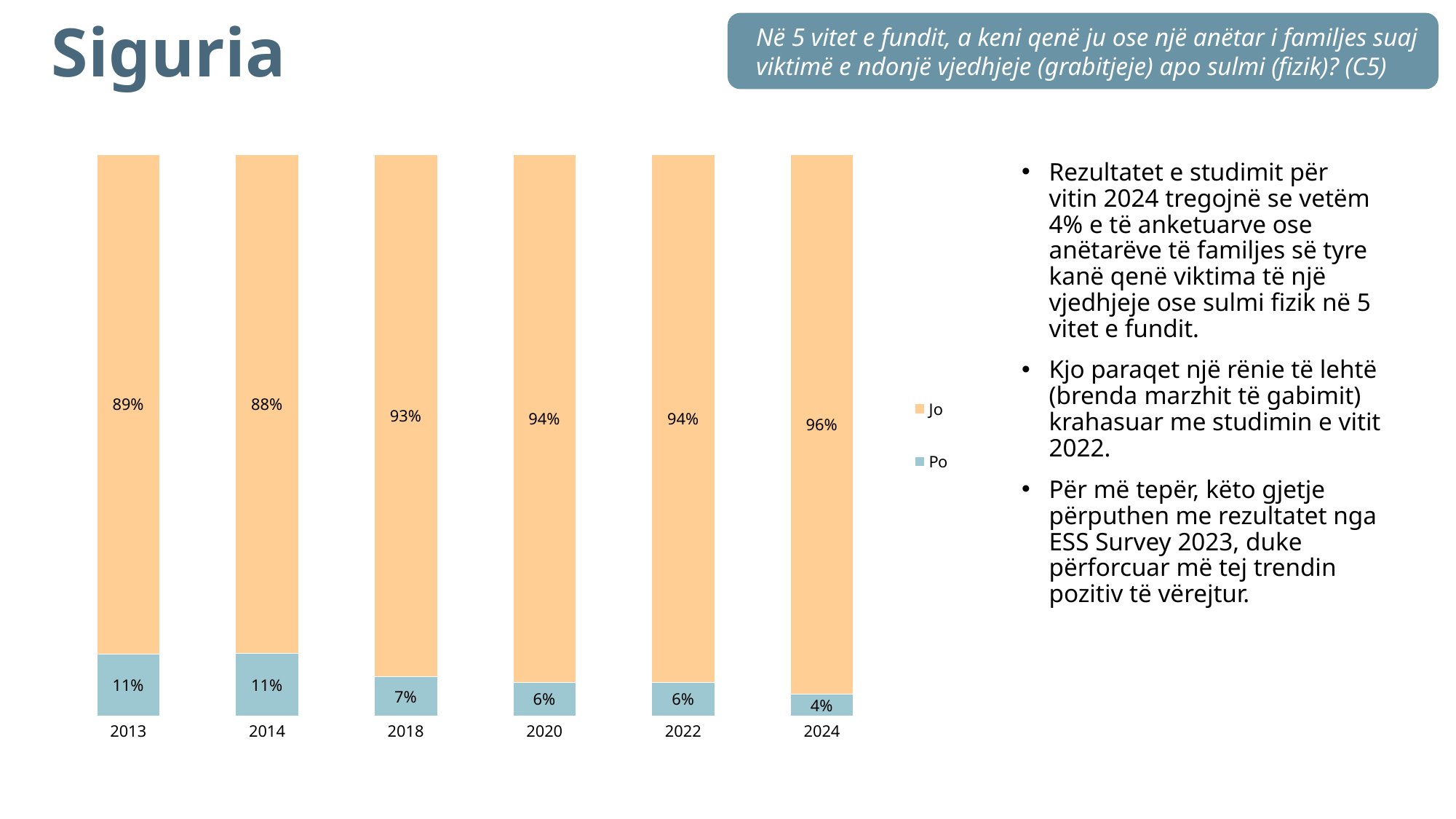
In which year is the "Po" value lowest? 2024 How many years are shown on the x axis? 6 In which year is the "Jo" value lowest? 2014 What is the value for "Po" in 2013? 11% How many series does the legend list? 2 Which is larger, the "Jo" value for 2018 or the "Jo" value for 2022? 2022 Does the "Po" value rise or fall from 2013 to 2024? Fall What is the value for "Po" in 2018? 7% What kind of chart is shown? Stacked bar chart What is the value for "Jo" in 2024? 96% What is the difference between the "Po" values for 2013 and 2024? 7% What is the value for "Jo" in 2014? 88%